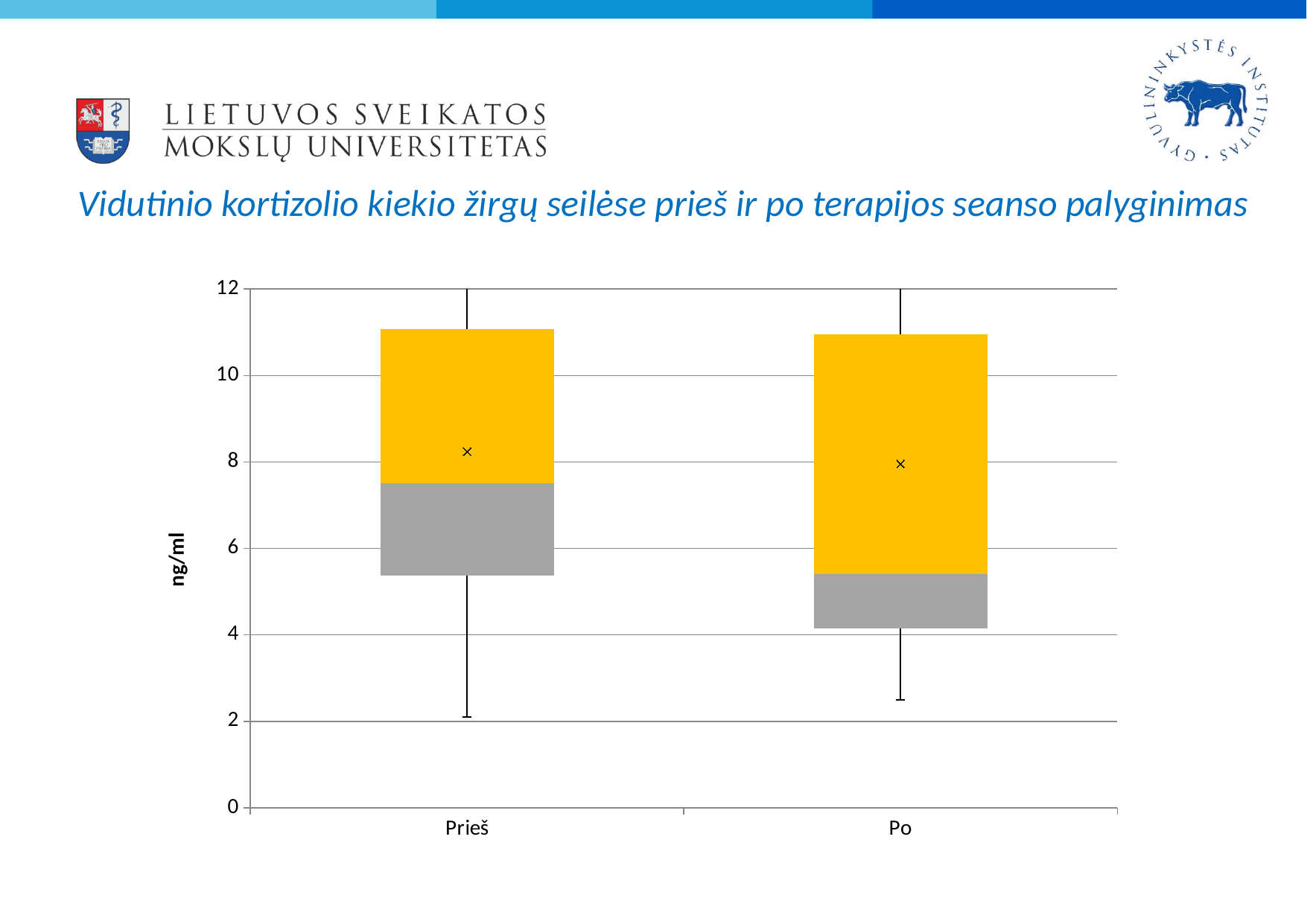
Which category has the higher median, Prieš or Po? Prieš Is the bottom of the lower whisker for Prieš greater or less than 4? less What is the title of the chart? Vidutinio kortizolio kiekio žirgų seilėse prieš ir po terapijos seanso palyginimas What unit is shown on the y axis label? ng/ml Is the median (boundary between the grey and yellow boxes) for Prieš greater or less than 6? greater Which category has the higher bottom edge of its grey box, Prieš or Po? Prieš Is the median (boundary between the grey and yellow boxes) for Po greater or less than 6? less How many categories are shown on the x axis? 2 What kind of chart is shown on the slide? box plot